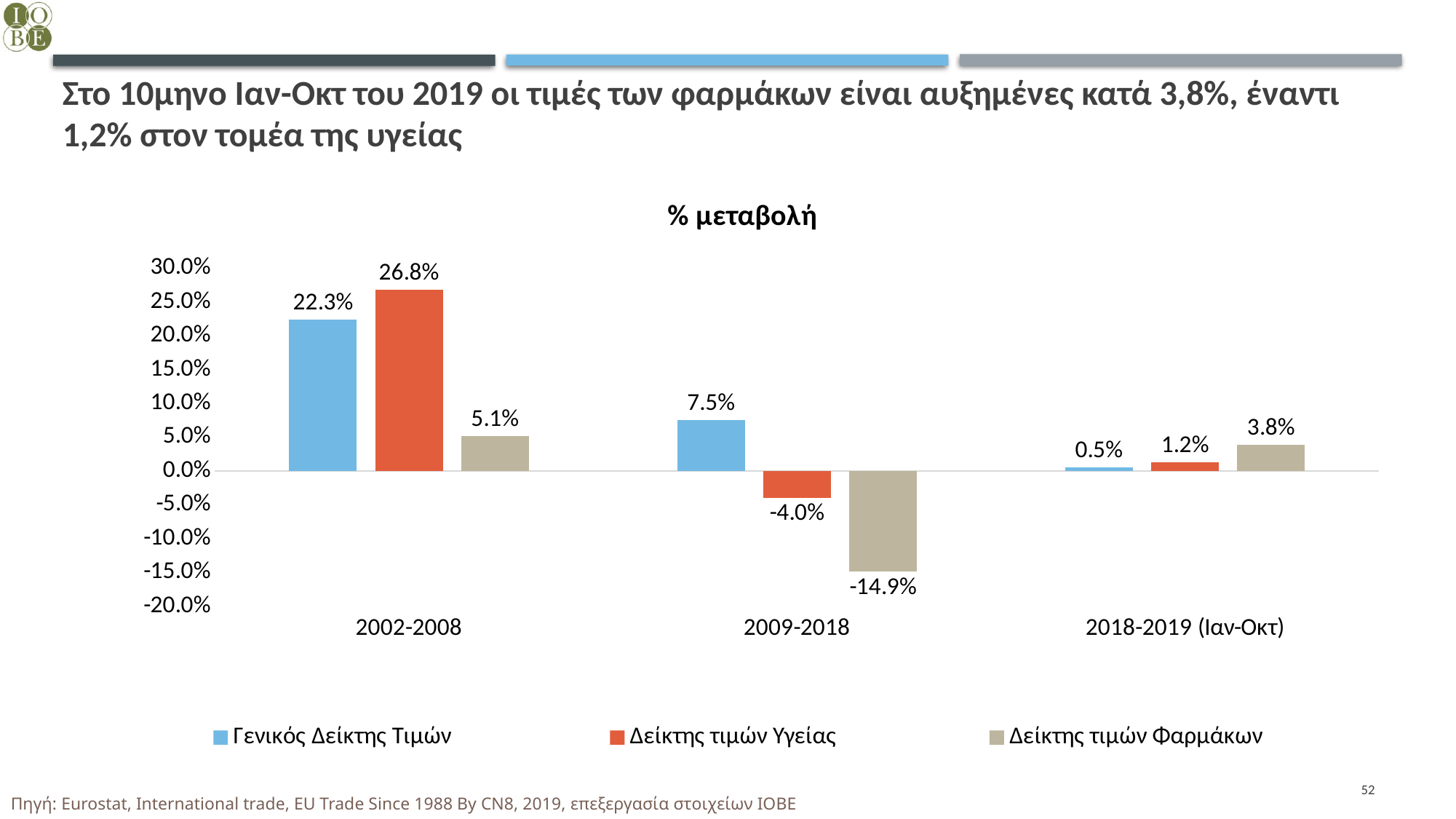
How many periods are shown on the x axis? 3 Which series has the lowest value in 2009-2018? Δείκτης τιμών Φαρμάκων Which period has the highest value for Γενικός Δείκτης Τιμών? 2002-2008 How many series does the legend list? 3 What is the title of the chart? % μεταβολή What is the value of Δείκτης τιμών Υγείας for 2002-2008? 26.8% Does the value of Γενικός Δείκτης Τιμών rise or fall across the periods from 2002-2008 to 2018-2019 (Ιαν-Οκτ)? fall What is the difference between Δείκτης τιμών Υγείας and Γενικός Δείκτης Τιμών in 2002-2008? 4.5% Which is larger in 2018-2019 (Ιαν-Οκτ): Δείκτης τιμών Φαρμάκων or Δείκτης τιμών Υγείας? Δείκτης τιμών Φαρμάκων What is the value of Γενικός Δείκτης Τιμών for 2018-2019 (Ιαν-Οκτ)? 0.5% What is the value of Δείκτης τιμών Φαρμάκων for 2009-2018? -14.9% What kind of chart is shown? bar chart